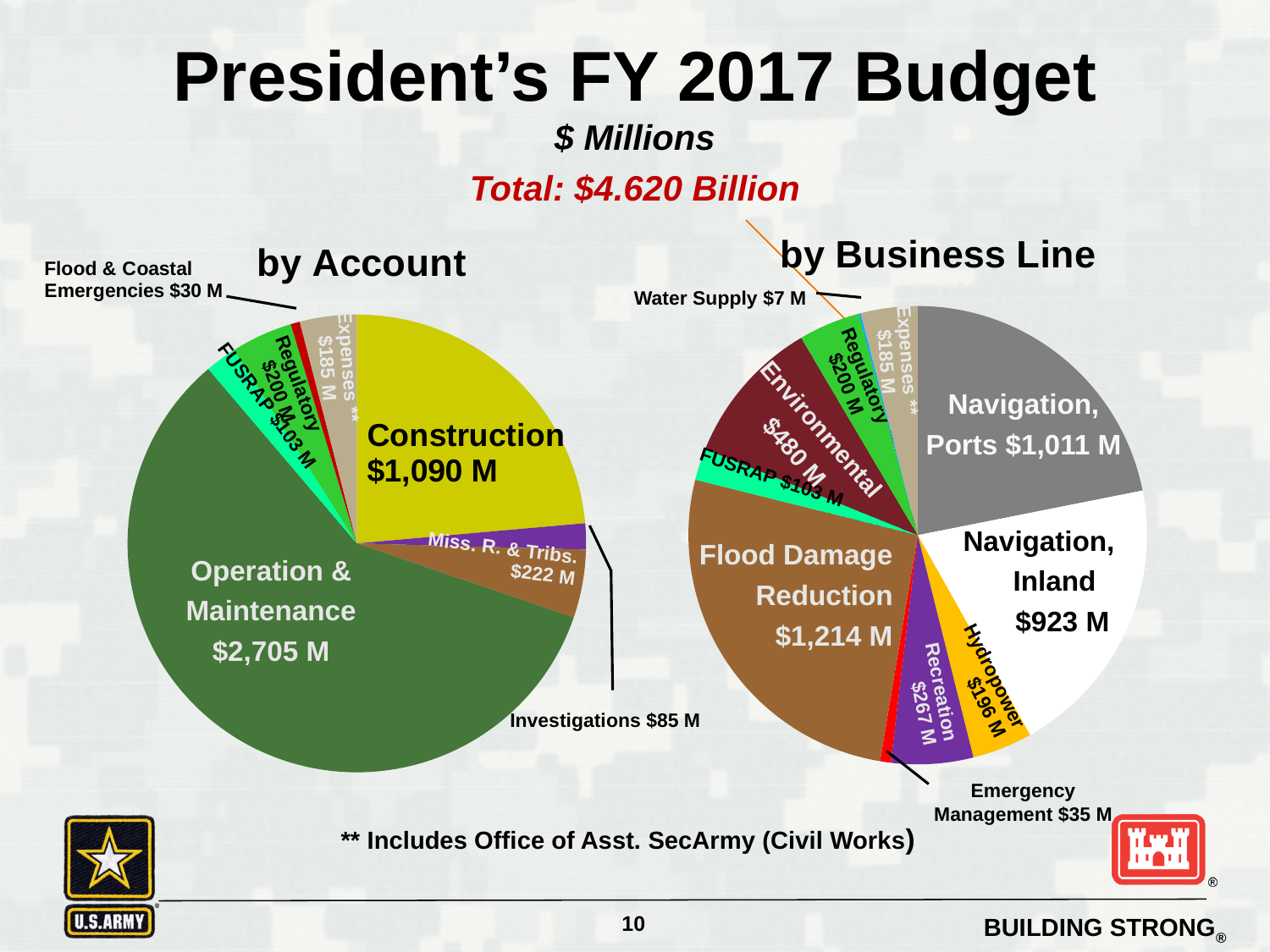
In the 'by Business Line' pie chart, which is larger: Navigation, Ports or Navigation, Inland? Navigation, Ports In the 'by Account' pie chart, which category has the smallest value? Flood & Coastal Emergencies In the 'by Business Line' pie chart, which category has the smallest value? Water Supply In the 'by Account' pie chart, what is the difference between Construction and Miss. R. & Tribs.? $868 M In the 'by Business Line' pie chart, what is the value for Flood Damage Reduction? $1,214 M In the 'by Account' pie chart, what is the value for Operation & Maintenance? $2,705 M In the 'by Account' pie chart, which category has the largest value? Operation & Maintenance In the 'by Business Line' pie chart, which category has the largest value? Flood Damage Reduction How many slices does the 'by Business Line' pie chart have? 11 In the 'by Account' pie chart, what is the value for Miss. R. & Tribs.? $222 M In the 'by Business Line' pie chart, what is the value for Hydropower? $196 M What kind of chart is the 'by Account' chart? Pie chart